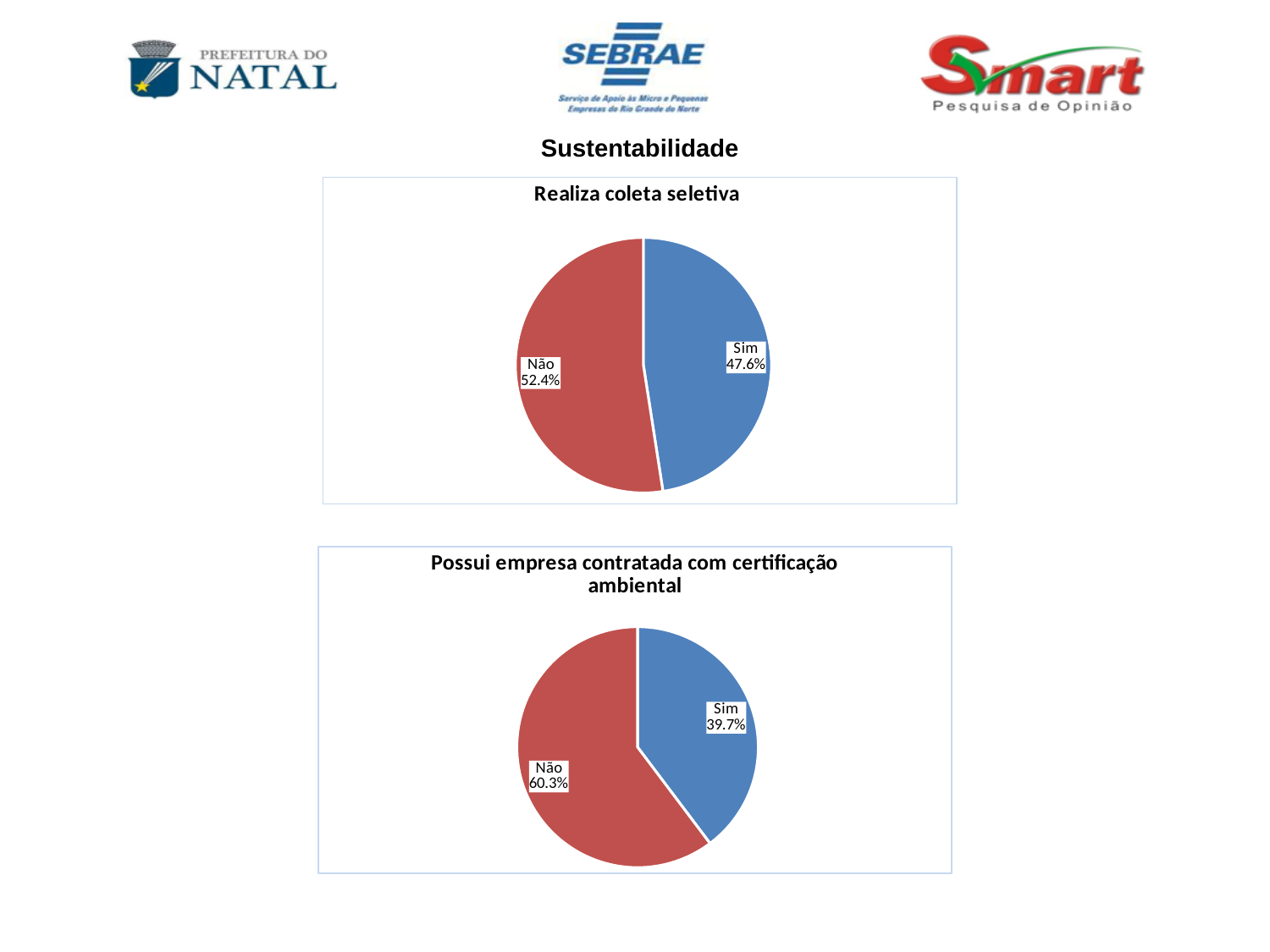
In the 'Possui empresa contratada com certificação ambiental' chart, what share of the pie is 'Sim'? 39.7% In the 'Possui empresa contratada com certificação ambiental' chart, which slice is the largest? Não In the 'Possui empresa contratada com certificação ambiental' chart, what share of the pie is 'Não'? 60.3% In the 'Possui empresa contratada com certificação ambiental' chart, what is the difference between the 'Não' and 'Sim' shares? 20.6% In the 'Realiza coleta seletiva' chart, what colour is the 'Não' slice? Red Which chart has the larger 'Sim' share, 'Realiza coleta seletiva' or 'Possui empresa contratada com certificação ambiental'? Realiza coleta seletiva How many slices does the 'Possui empresa contratada com certificação ambiental' chart have? 2 In the 'Realiza coleta seletiva' chart, what is the difference between the 'Não' and 'Sim' shares? 4.8% In the 'Realiza coleta seletiva' chart, which slice is larger, 'Sim' or 'Não'? Não In the 'Realiza coleta seletiva' chart, what share of the pie is 'Sim'? 47.6% What kind of chart is the 'Realiza coleta seletiva' chart? Pie chart